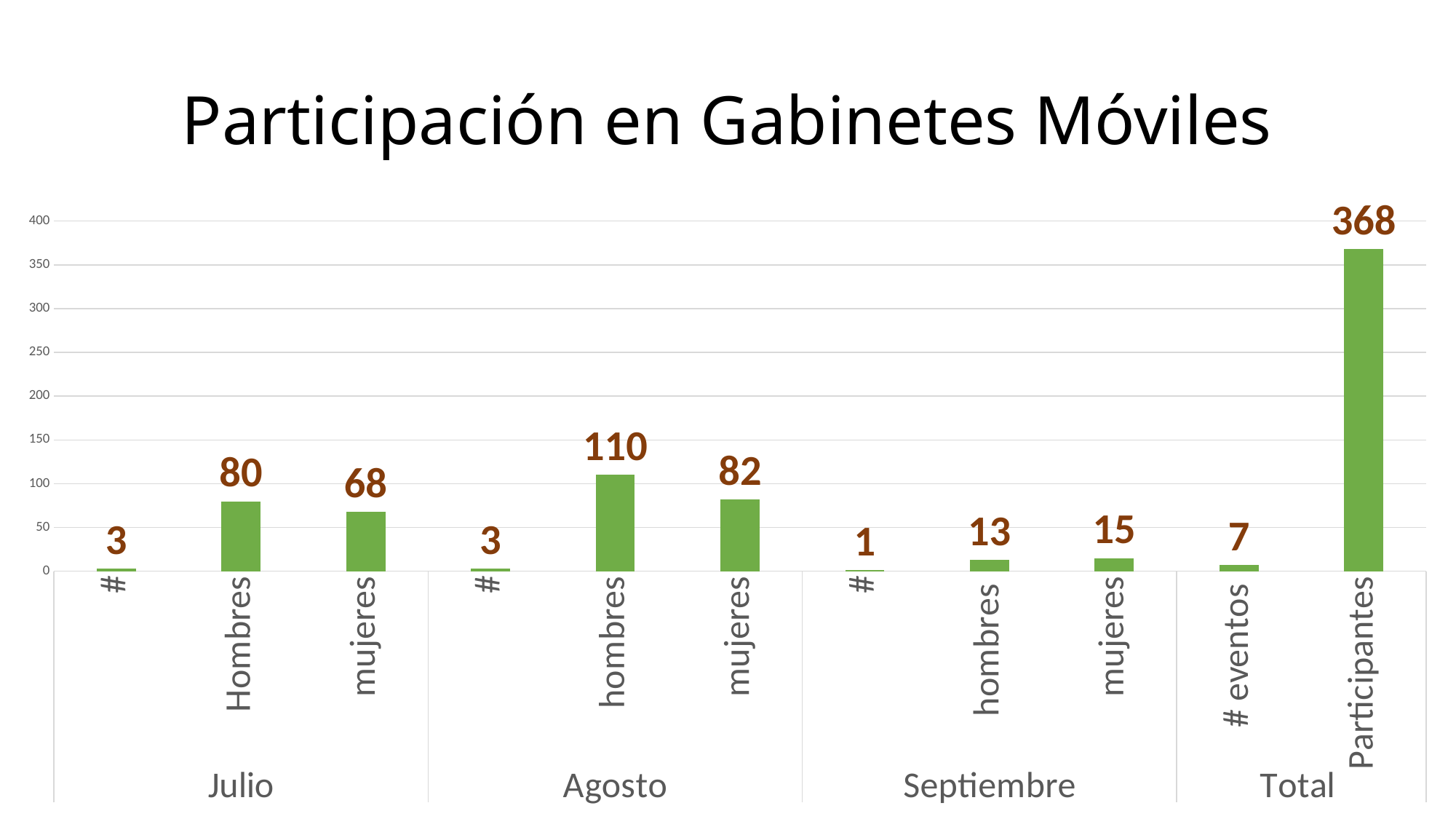
Which bar has the highest value? Participantes How many bars are plotted in the chart? 11 What is the value for mujeres in Agosto? 82 Which is larger, hombres in Septiembre or mujeres in Septiembre? mujeres in Septiembre Which bar has the lowest value? # in Septiembre What is the value for Hombres in Julio? 80 What is the value for Participantes in the Total group? 368 What kind of chart is shown on the slide? bar chart What is the difference between hombres and mujeres in Agosto? 28 What is the title of the chart? Participación en Gabinetes Móviles Is the value for hombres in Agosto greater or less than 100? greater What is the value for # eventos in the Total group? 7